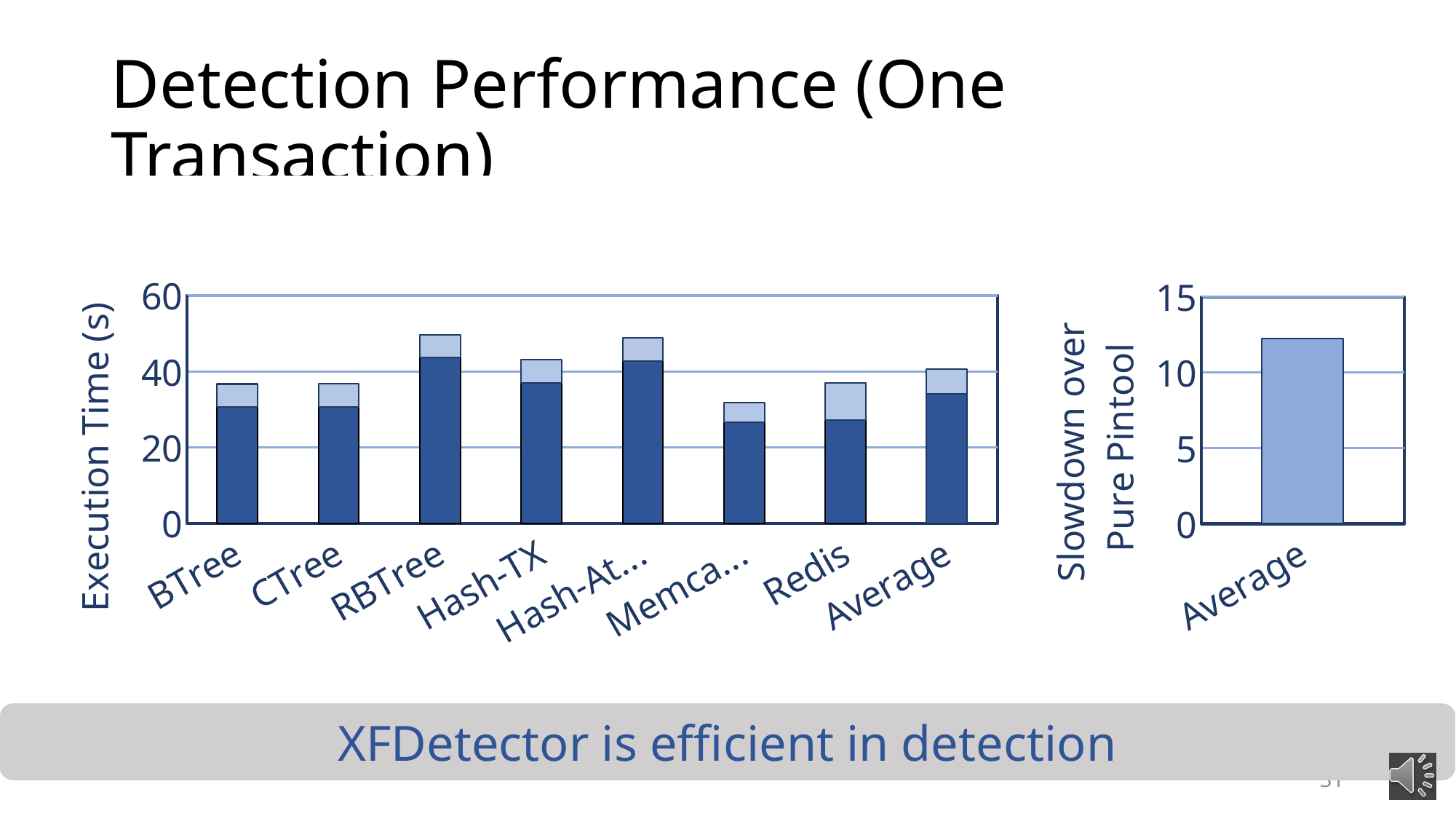
In the left chart (Execution Time), is the total value for RBTree greater or less than 40? greater In the left chart (Execution Time), which category has the lowest total execution time? Memca... In the left chart (Execution Time), which has the larger total execution time, RBTree or CTree? RBTree How many categories are shown on the x axis of the left chart (Execution Time)? 8 In the right chart (Slowdown over Pure Pintool), is the value for Average greater or less than 10? greater What kind of chart is the left chart showing Execution Time (s)? bar chart In the left chart (Execution Time), is the total value for Memca... greater or less than 20? greater In the left chart (Execution Time), which has the larger total execution time, Hash-TX or Redis? Hash-TX What is the y-axis label of the left chart? Execution Time (s) How many bars are shown in the right chart (Slowdown over Pure Pintool)? 1